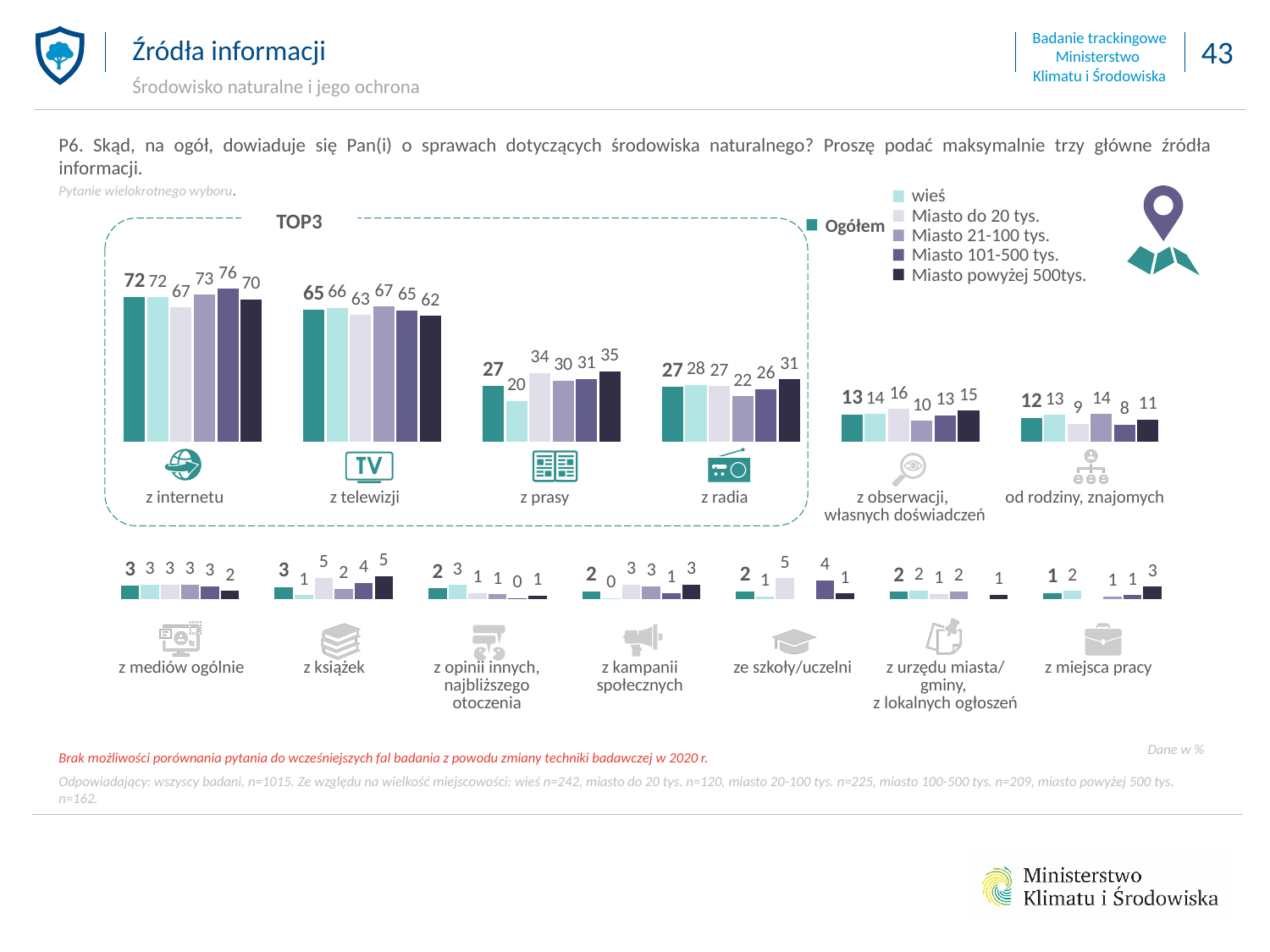
How many series does the legend list (including Ogółem)? 6 Which categories are grouped inside the dashed 'TOP3' box? z internetu, z telewizji, z prasy, z radia What is the 'wieś' value for 'z telewizji'? 66 What is the Ogółem value for 'z internetu'? 72 Within the 'od rodziny, znajomych' category, which series has the lowest value? Miasto 101-500 tys. Which is larger for 'z radia': the 'wieś' value or the 'Miasto 21-100 tys.' value? wieś Which category has the highest Ogółem value? z internetu What is the value for 'Miasto powyżej 500tys.' in the 'z prasy' category? 35 Within the 'z internetu' category, which series has the highest value? Miasto 101-500 tys. How many source categories are shown in the chart? 13 What is the difference between the 'Miasto powyżej 500tys.' value and the 'wieś' value for 'z prasy'? 15 What type of chart is shown on the slide? bar chart